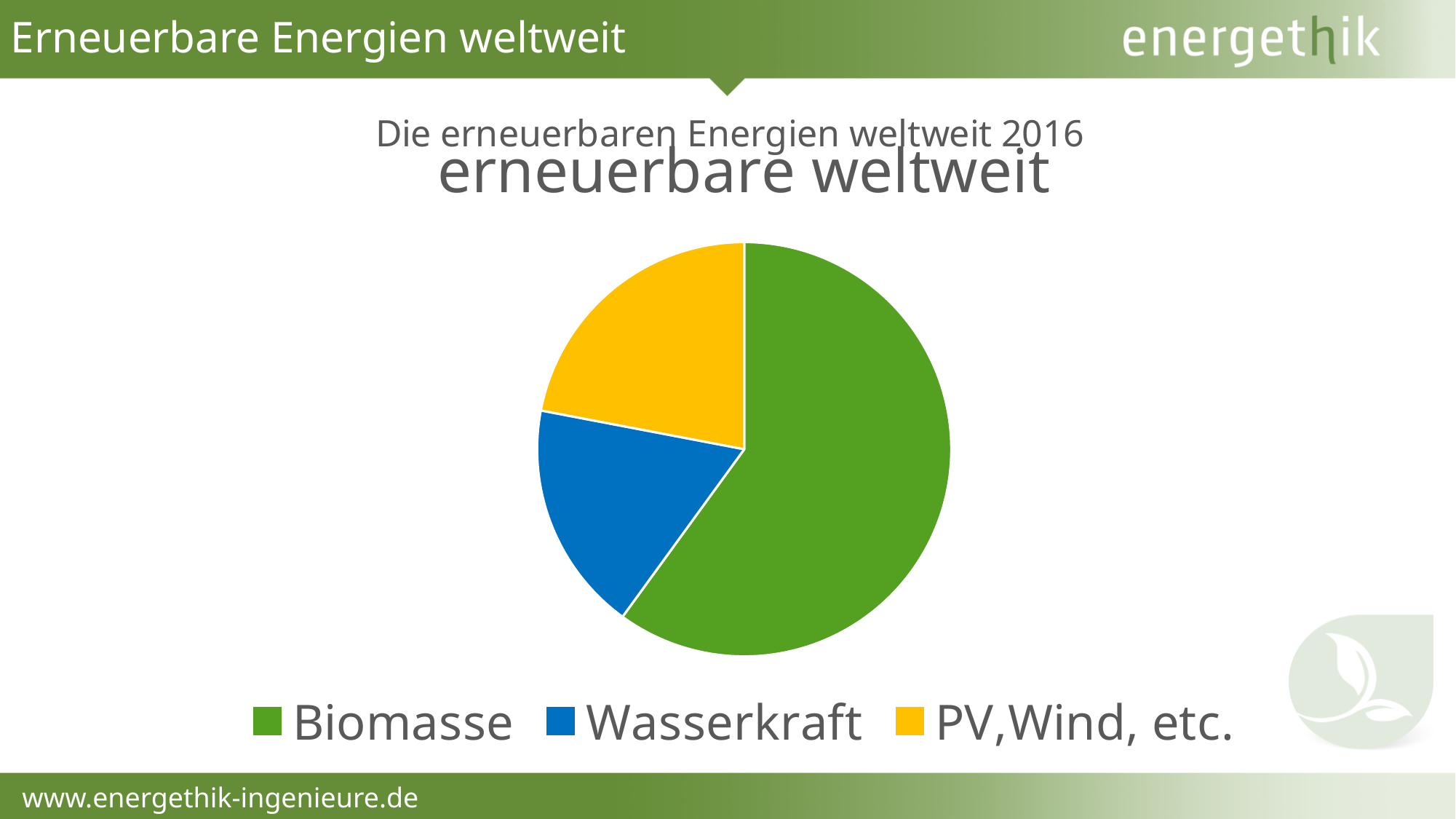
How many entries does the legend of the pie chart list? 3 What colour is the Wasserkraft slice in the pie chart? blue Does the Biomasse slice take up more or less than half of the pie? more What kind of chart is shown on the slide? pie chart How many slices does the pie chart have? 3 Which slice is larger, Biomasse or Wasserkraft? Biomasse Which category has the smallest slice in the pie chart? Wasserkraft Which slice is larger, PV,Wind, etc. or Wasserkraft? PV,Wind, etc. Which category has the largest slice in the pie chart? Biomasse Which category is shown in yellow in the pie chart? PV,Wind, etc. Which slice is larger, Biomasse or PV,Wind, etc.? Biomasse